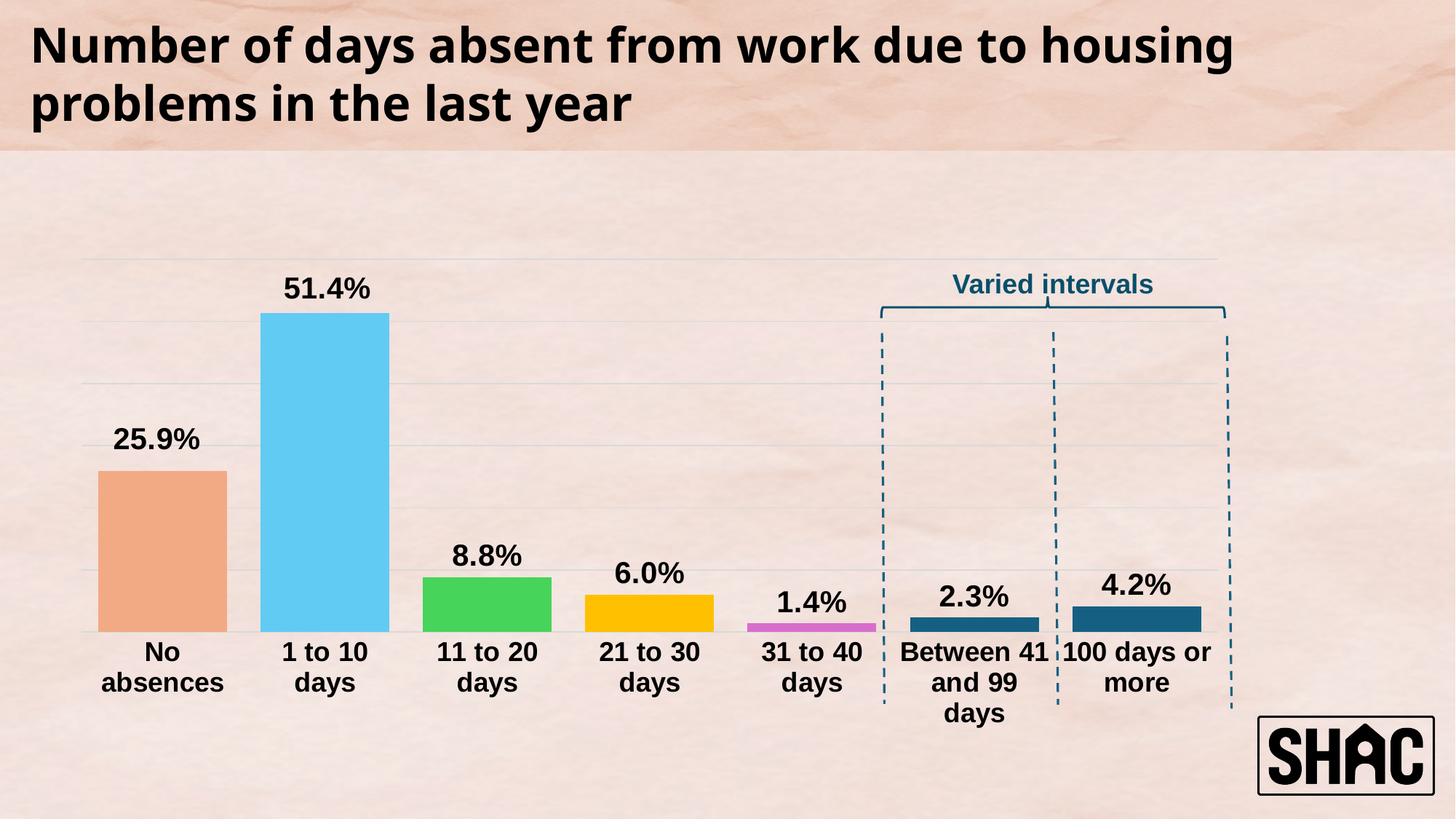
What is the value for the '1 to 10 days' category? 51.4% What label is shown above the bracket covering the last two categories? Varied intervals What is the difference between the '1 to 10 days' and 'No absences' percentages? 25.5% What percentage of respondents reported no absences? 25.9% What is the title of the chart? Number of days absent from work due to housing problems in the last year What percentage is shown for '31 to 40 days'? 1.4% What type of chart is shown on the slide? Bar chart Which is larger: the value for '11 to 20 days' or '21 to 30 days'? 11 to 20 days How many categories are shown on the x axis? 7 Which category has the lowest percentage? 31 to 40 days What is the value for '100 days or more'? 4.2% Which category has the highest percentage? 1 to 10 days